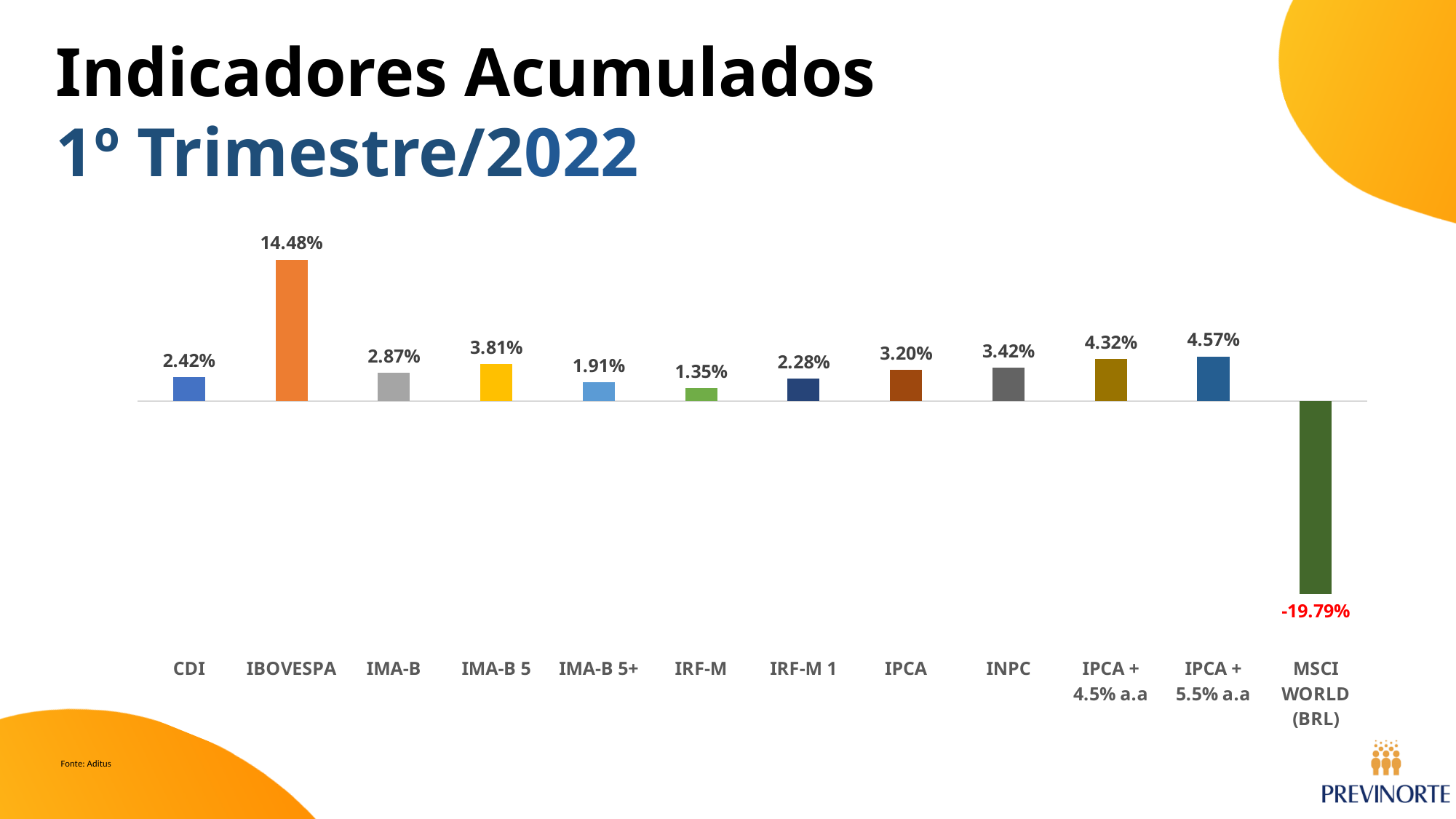
How many categories are shown on the chart? 12 What is the value for IPCA + 5.5% a.a? 4.57% What is the value for IBOVESPA? 14.48% What is the difference between the values for IBOVESPA and CDI? 12.06% What is the source cited at the bottom of the slide? Aditus What is the difference between the values for IMA-B 5 and IMA-B 5+? 1.90% Which category has the lowest value? MSCI WORLD (BRL) What is the value for IRF-M? 1.35% What kind of chart is shown on the slide? Bar chart What is the value for MSCI WORLD (BRL)? -19.79% Which is larger, the value for IPCA or the value for INPC? INPC Which category has the highest value? IBOVESPA